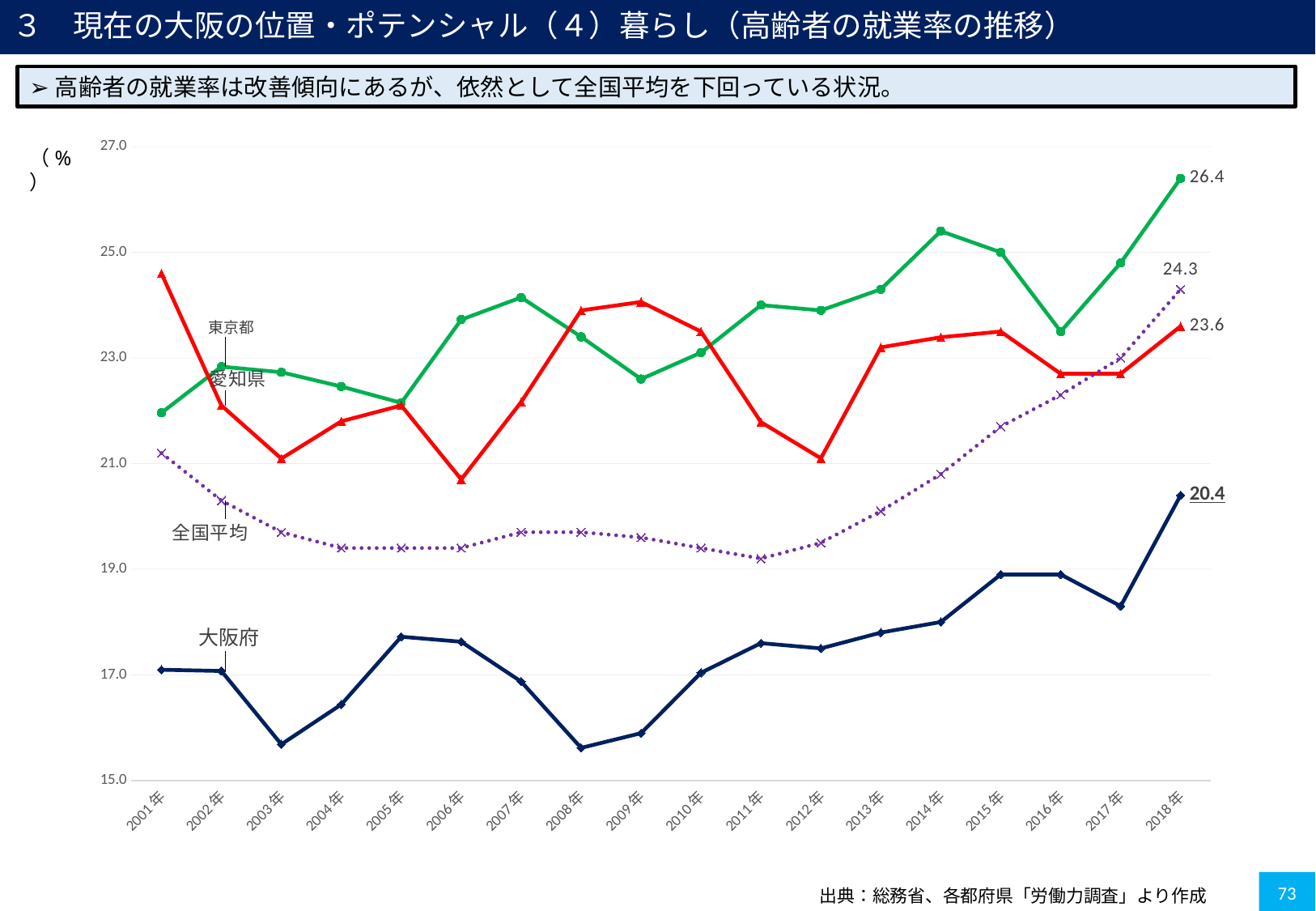
What kind of chart is shown on the slide? line chart What is the value for 愛知県 in 2018年? 23.6 Is the value for 大阪府 in 2008年 greater or less than 17.0? less How many years are shown on the x axis? 18 What is the value for 大阪府 in 2018年? 20.4 What is the difference between 東京都 and 大阪府 in 2018年? 6.0 Which series has the highest value in 2018年? 東京都 What is the value for 全国平均 in 2018年? 24.3 What is the difference between 全国平均 and 大阪府 in 2018年? 3.9 What is the value for 東京都 in 2018年? 26.4 Which series has the lowest value in 2018年? 大阪府 In 2018年, which is larger: 愛知県 or 全国平均? 全国平均